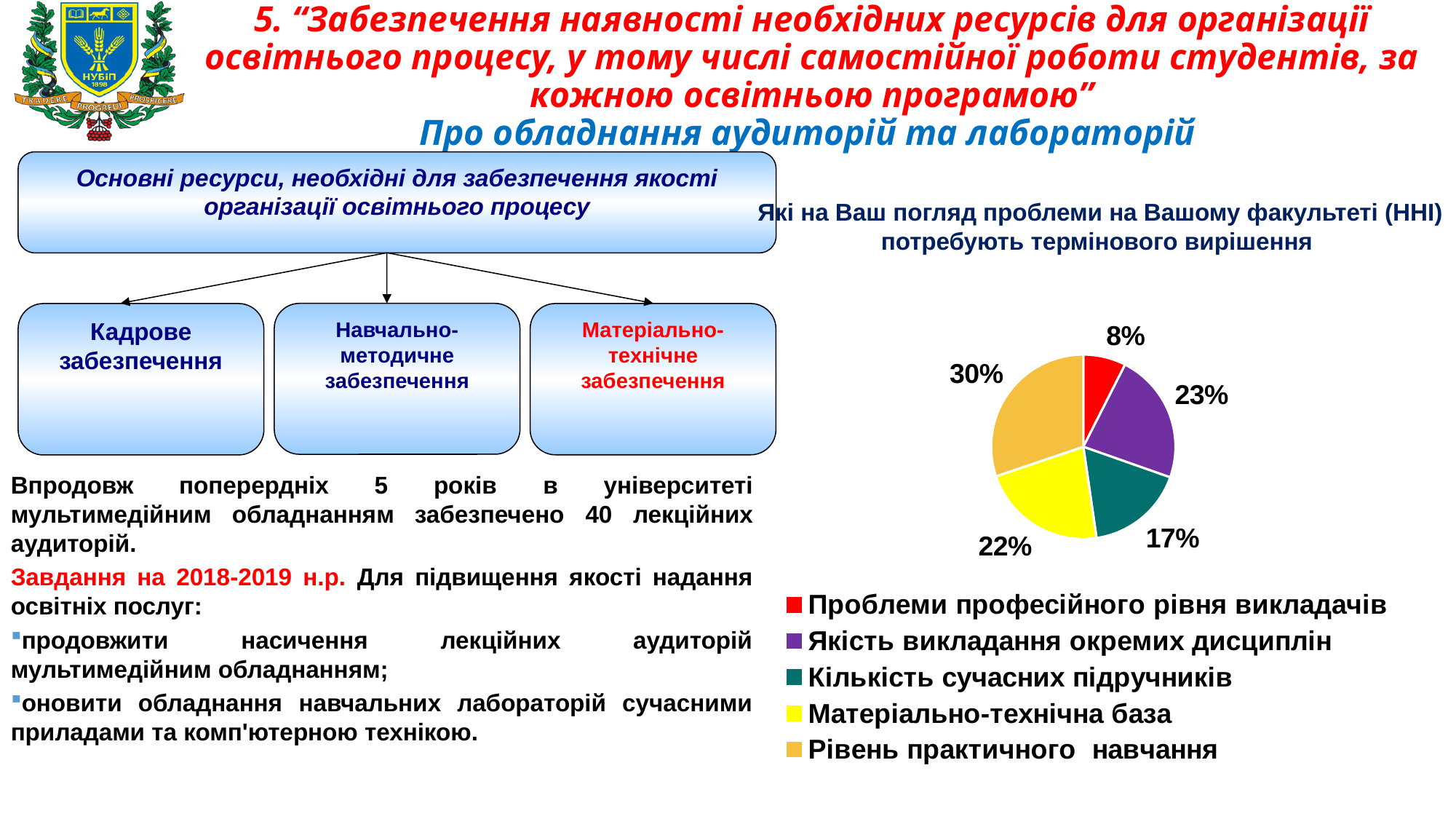
What share of the pie does "Матеріально-технічна база" have? 22% What kind of chart is shown on the slide? pie chart Which category has the largest slice of the pie? Рівень практичного навчання How many slices does the pie chart have? 5 What is the difference in percentage points between "Рівень практичного навчання" and "Кількість сучасних підручників"? 13 What share of the pie does "Кількість сучасних підручників" have? 17% What share of the pie does "Проблеми професійного рівня викладачів" have? 8% Which category has the smallest slice of the pie? Проблеми професійного рівня викладачів Which is larger: the slice for "Якість викладання окремих дисциплін" or the slice for "Матеріально-технічна база"? Якість викладання окремих дисциплін What colour is the slice for "Матеріально-технічна база"? yellow